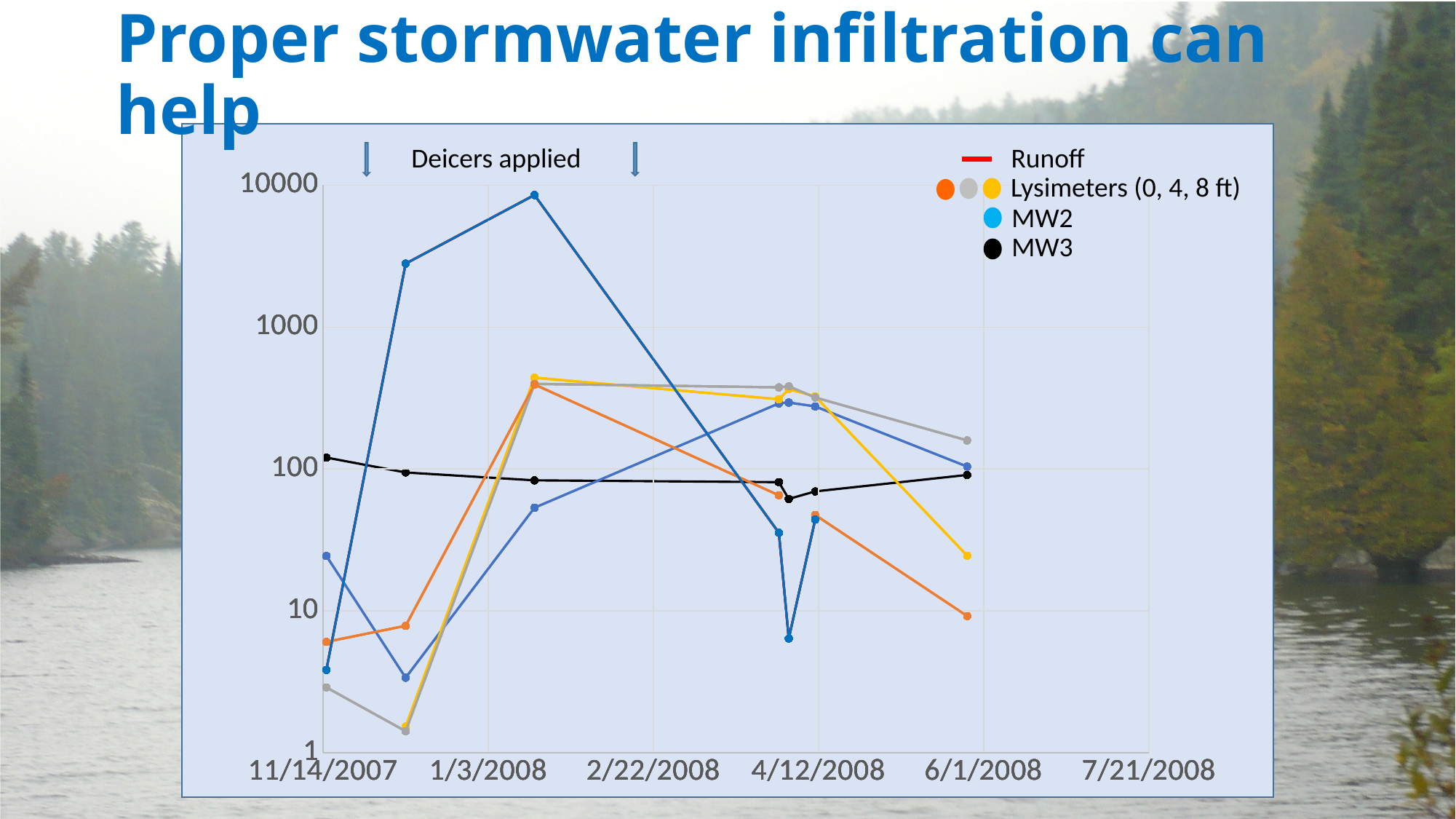
Does the MW3 line rise or fall from 11/14/2007 to 4/12/2008? fall What is the highest value labelled on the y axis? 10000 Is the highest plotted value on the chart greater or less than 1000? greater Is the lowest plotted value on the chart greater or less than 10? less Is the yellow lysimeter value at 6/1/2008 greater or less than 100? less What depths are listed for the lysimeters in the legend? 0, 4, 8 ft How many entries does the chart legend list? 4 What kind of chart is shown on the slide? line chart Which series is shown in black in the legend? MW3